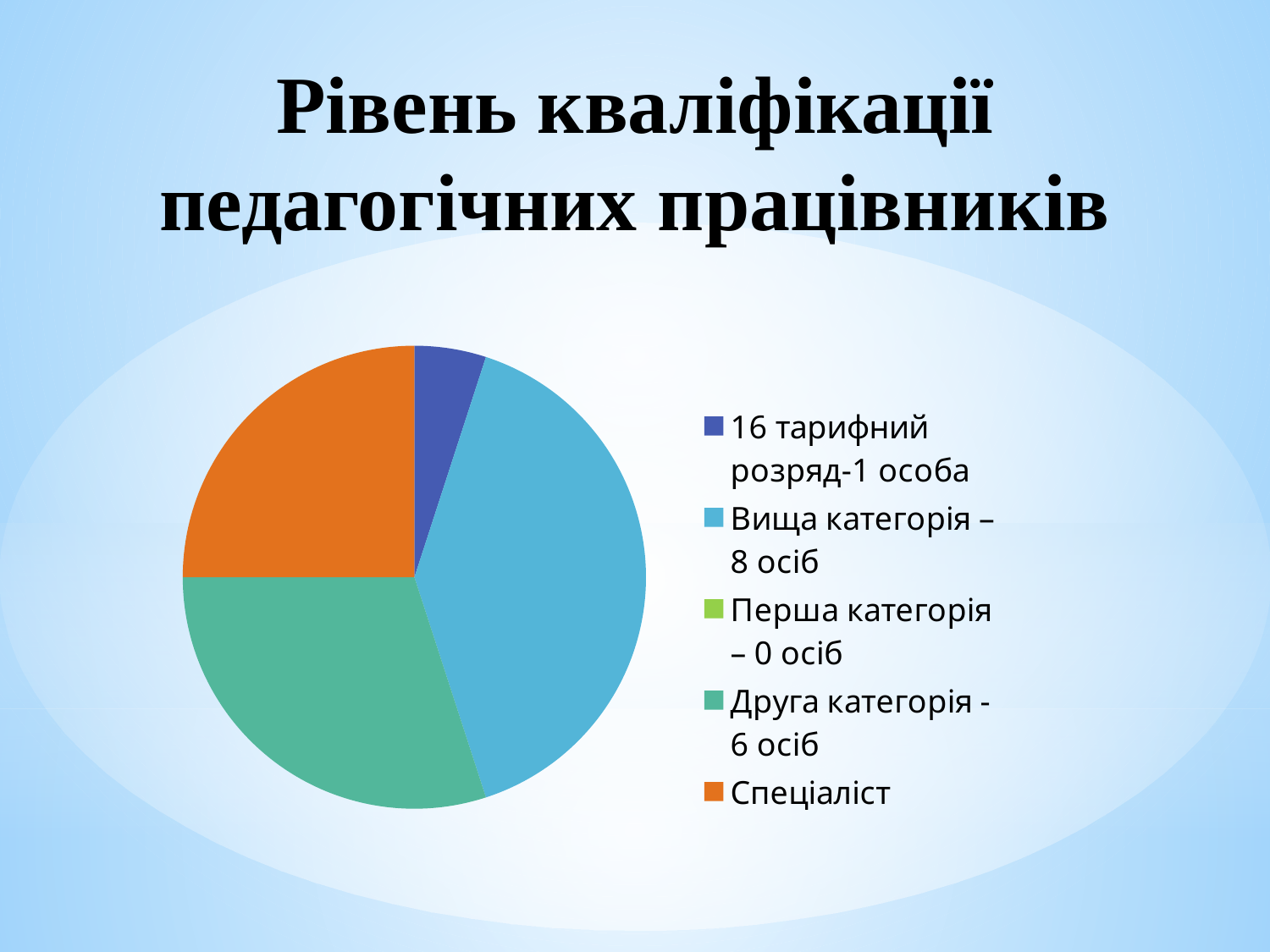
According to the legend, how many people have 'Перша категорія'? 0 осіб Which category has the largest slice of the pie chart? Вища категорія What colour is the slice for 'Спеціаліст' in the pie chart? orange Which is larger: the slice for 'Вища категорія' or the slice for 'Друга категорія'? Вища категорія According to the legend, how many people have '16 тарифний розряд'? 1 особа Which legend category has the smallest number of people? Перша категорія What is the title of the slide with the pie chart? Рівень кваліфікації педагогічних працівників According to the legend, how many people have 'Друга категорія'? 6 осіб What is the difference between the number of people with 'Вища категорія' and with 'Друга категорія'? 2 How many entries does the legend of the pie chart list? 5 According to the legend, how many people have 'Вища категорія'? 8 осіб What kind of chart is shown on the slide? pie chart